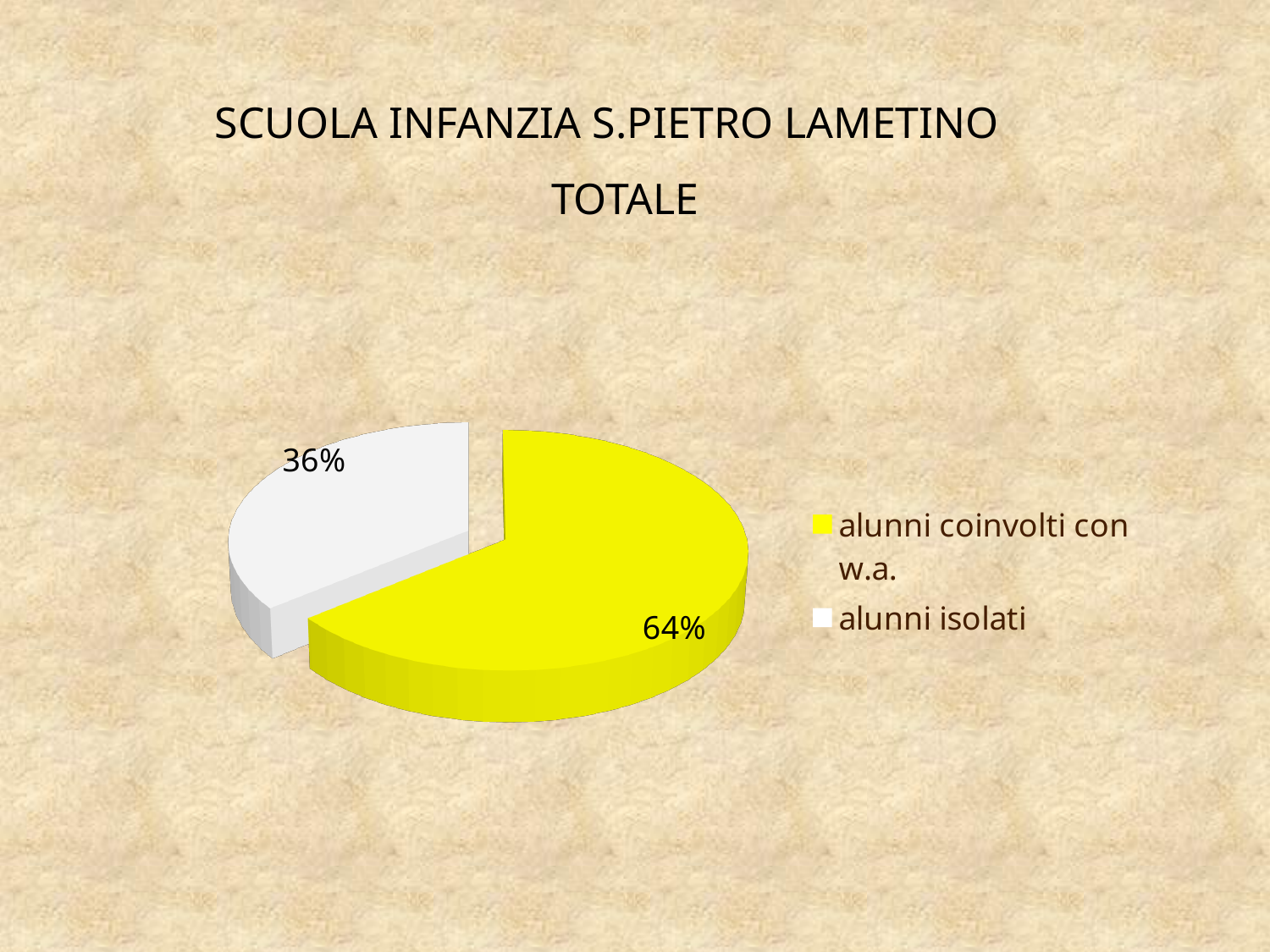
What colour is the slice for "alunni coinvolti con w.a."? yellow What share of the pie is labelled "alunni coinvolti con w.a."? 64% What is the difference in percentage points between the "alunni coinvolti con w.a." slice and the "alunni isolati" slice? 28 percentage points What is the title of the chart? SCUOLA INFANZIA S.PIETRO LAMETINO TOTALE How many entries does the legend list? 2 Which category has the smallest slice of the pie? alunni isolati Which slice is larger, "alunni coinvolti con w.a." or "alunni isolati"? alunni coinvolti con w.a. How many slices does the pie chart have? 2 Which category has the largest slice of the pie? alunni coinvolti con w.a. What share of the pie is labelled "alunni isolati"? 36% What kind of chart is shown on the slide? pie chart